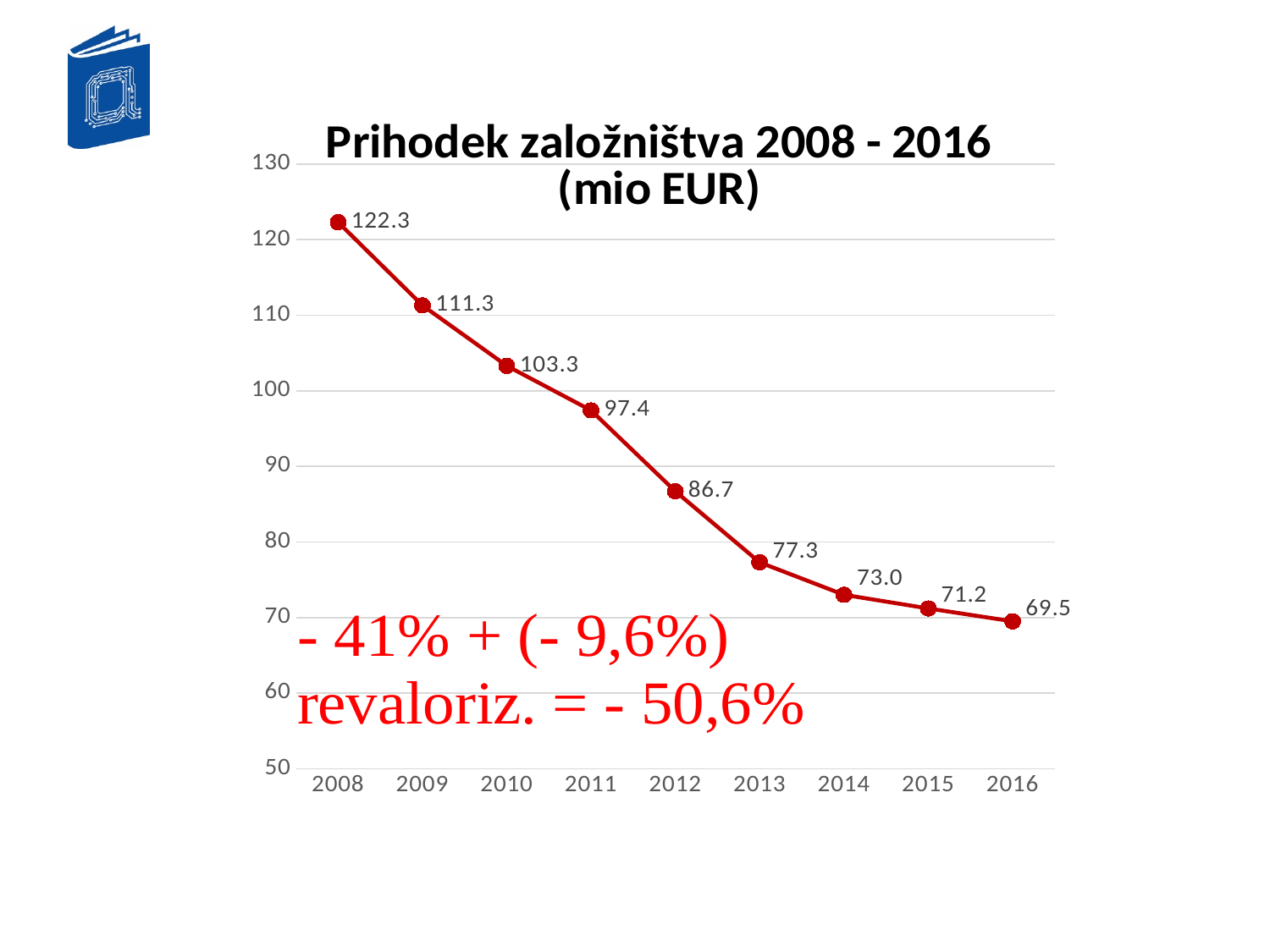
Which year has the lowest value? 2016 How many years are plotted on the chart? 9 What is the difference between the values for 2008 and 2016? 52.8 What is the value for 2012? 86.7 What kind of chart is shown? line chart What is the value for 2016? 69.5 Is the value for 2011 greater or less than 100? less Which year has the highest value? 2008 What is the value for 2008? 122.3 Do the values rise or fall from 2008 to 2016? fall What is the difference between the values for 2011 and 2012? 10.7 Which is larger, the value for 2010 or the value for 2013? 2010